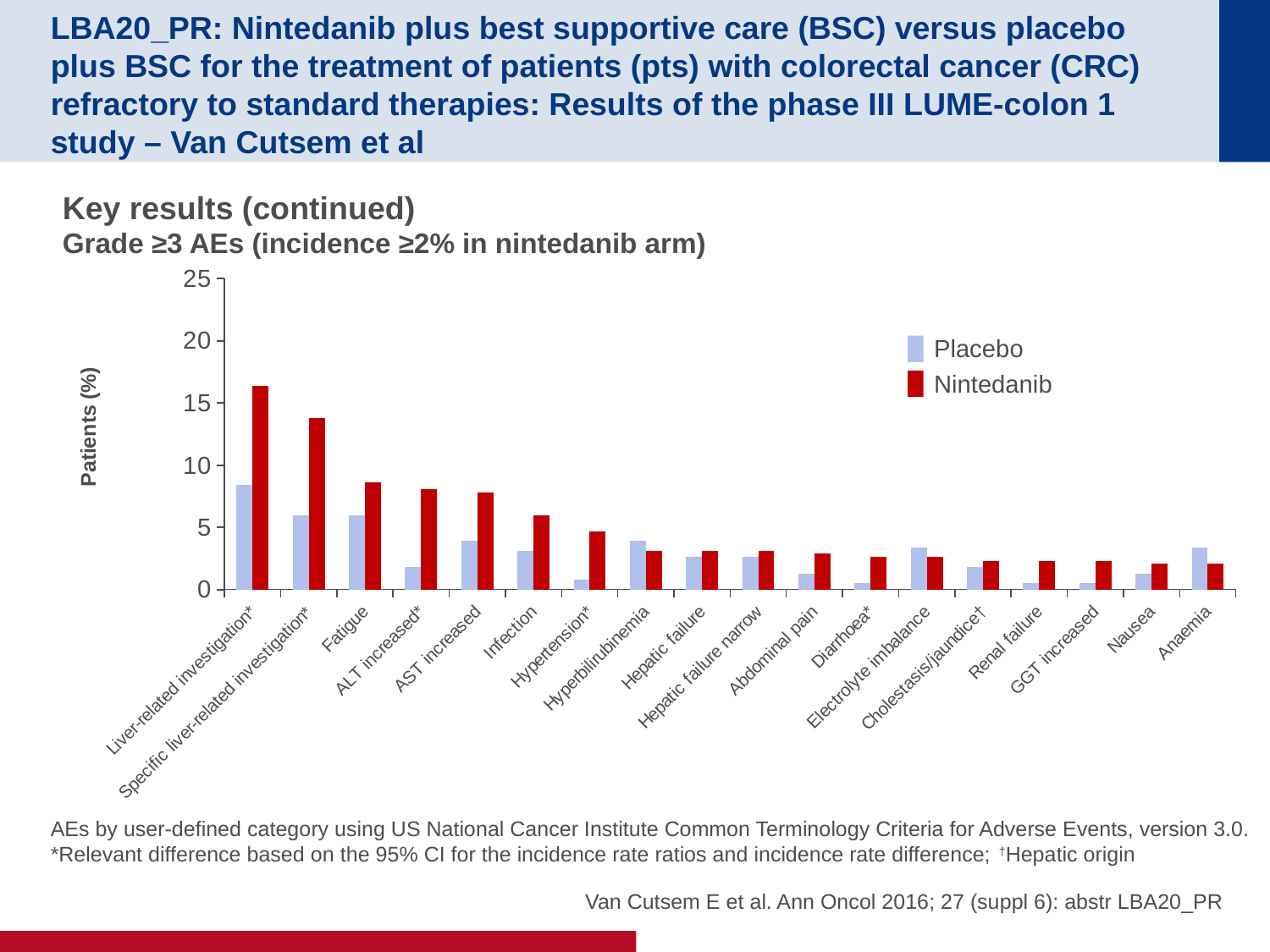
Do the Nintedanib values generally rise or fall from left to right along the x axis? fall What is the label on the y axis? Patients (%) What kind of chart is shown on the slide? Bar chart Is the Placebo value for ALT increased* greater or less than 5? less How many series does the legend list? 2 For Fatigue, which arm has the larger value, Placebo or Nintedanib? Nintedanib For Anaemia, which arm has the larger value, Placebo or Nintedanib? Placebo Which adverse event category has the highest value for Nintedanib? Liver-related investigation* How many adverse event categories are shown on the x axis? 18 Is the Nintedanib value for Specific liver-related investigation* greater or less than 10? greater Is the Nintedanib value for Liver-related investigation* greater or less than 15? greater